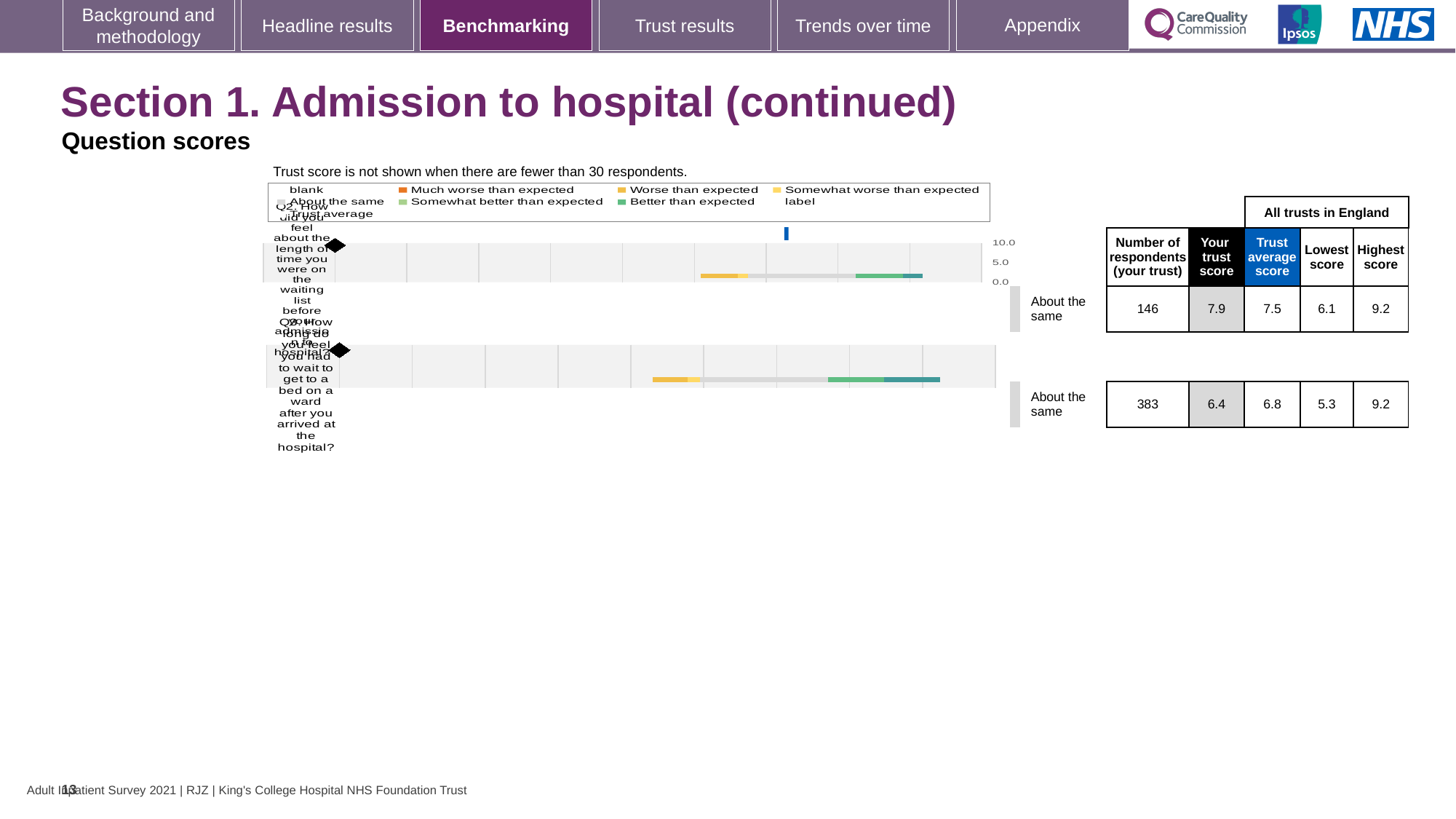
How is the trust's result for Q2 categorised relative to expectations? About the same What is the trust average score for Q2? 7.5 What kind of chart is used to show the question scores on this slide? bar chart What is the highest score across all trusts in England for Q2? 9.2 What is the trust score for Q2 (length of time on the waiting list before admission)? 7.9 What is the number of respondents for Q3? 383 How many questions are plotted in the chart? 2 What is the lowest score across all trusts in England for Q3? 5.3 What is the difference between the trust score and the trust average score for Q3? 0.4 What is the trust score for Q3 (wait to get to a bed on a ward after arriving at the hospital)? 6.4 Which question has the higher trust score, Q2 or Q3? Q2 What is the maximum value shown on the chart's score axis? 10.0